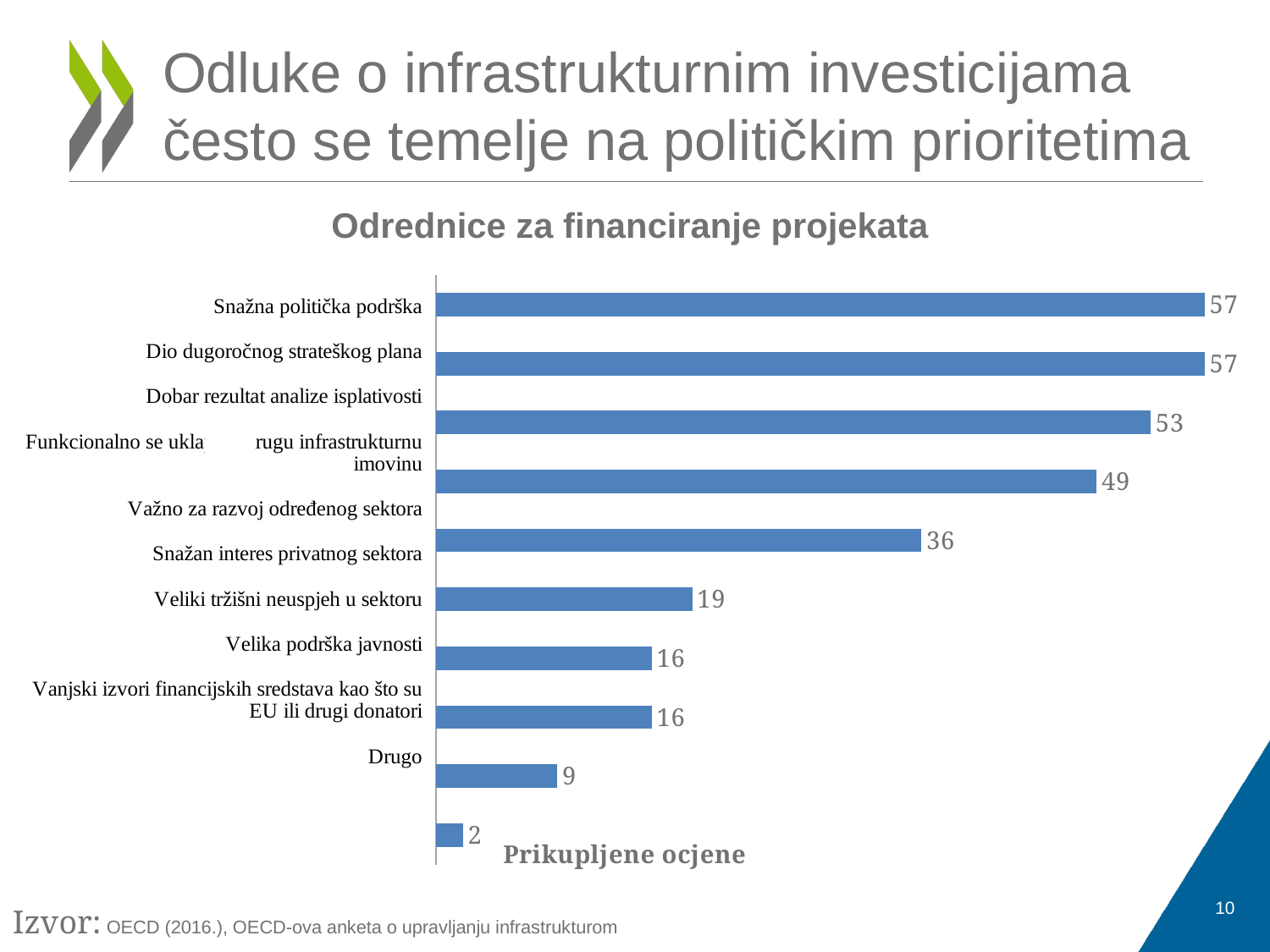
What is the value for Snažna politička podrška? 57 What is the difference between the highest bar value (57) and the lowest bar value (2)? 55 How many bars have a value of 16? 2 What is the lowest value shown on any bar in the chart? 2 What is the name of the data series shown below the chart? Prikupljene ocjene How many bars are plotted in the chart? 10 What is the highest value shown on any bar in the chart? 57 Which is larger, the value of the top bar or the value of the bottom bar? the top bar What is the value for Dio dugoročnog strateškog plana? 57 What is the title of the chart? Odrednice za financiranje projekata What kind of chart is shown on the slide? bar chart Do the bar values increase or decrease going from the top of the chart to the bottom? decrease